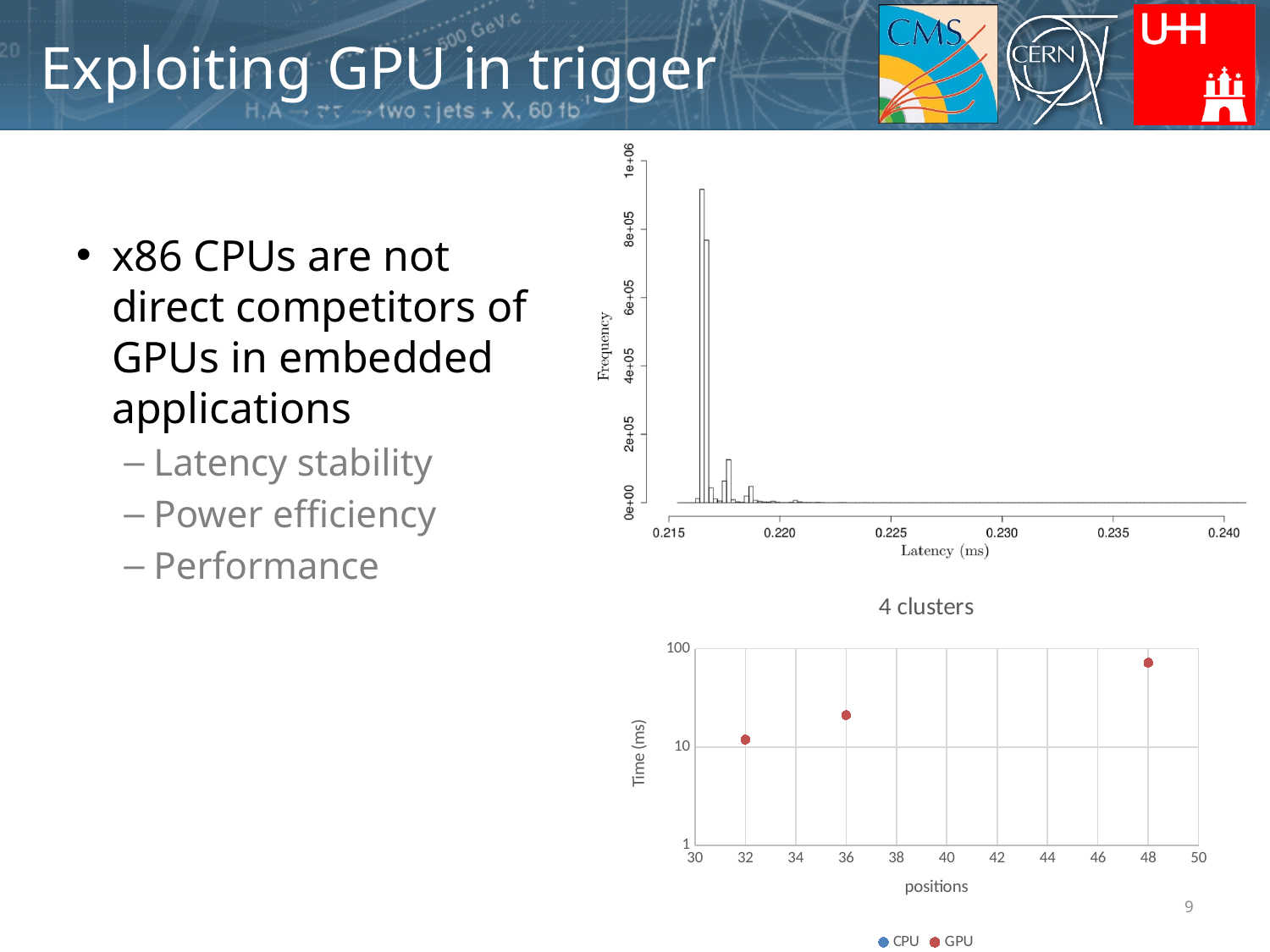
In the top chart (latency histogram), is the frequency of the tallest bar greater or less than 8e+05? greater In the bottom chart titled '4 clusters', how many series does the legend list? 2 In the bottom chart titled '4 clusters', is the time value at position 48 greater or less than 100? less What is the title of the bottom chart on the slide? 4 clusters In the bottom chart titled '4 clusters', does the time rise or fall as positions increase? rise In the bottom chart titled '4 clusters', is the time value at position 36 greater or less than 10? greater In the bottom chart titled '4 clusters', what are the two legend entries? CPU and GPU In the bottom chart titled '4 clusters', which position has the highest time value? 48 In the bottom chart titled '4 clusters', which position has the lowest time value? 32 What kind of chart is the bottom chart titled '4 clusters'? scatter chart In the bottom chart titled '4 clusters', how many data points are plotted? 3